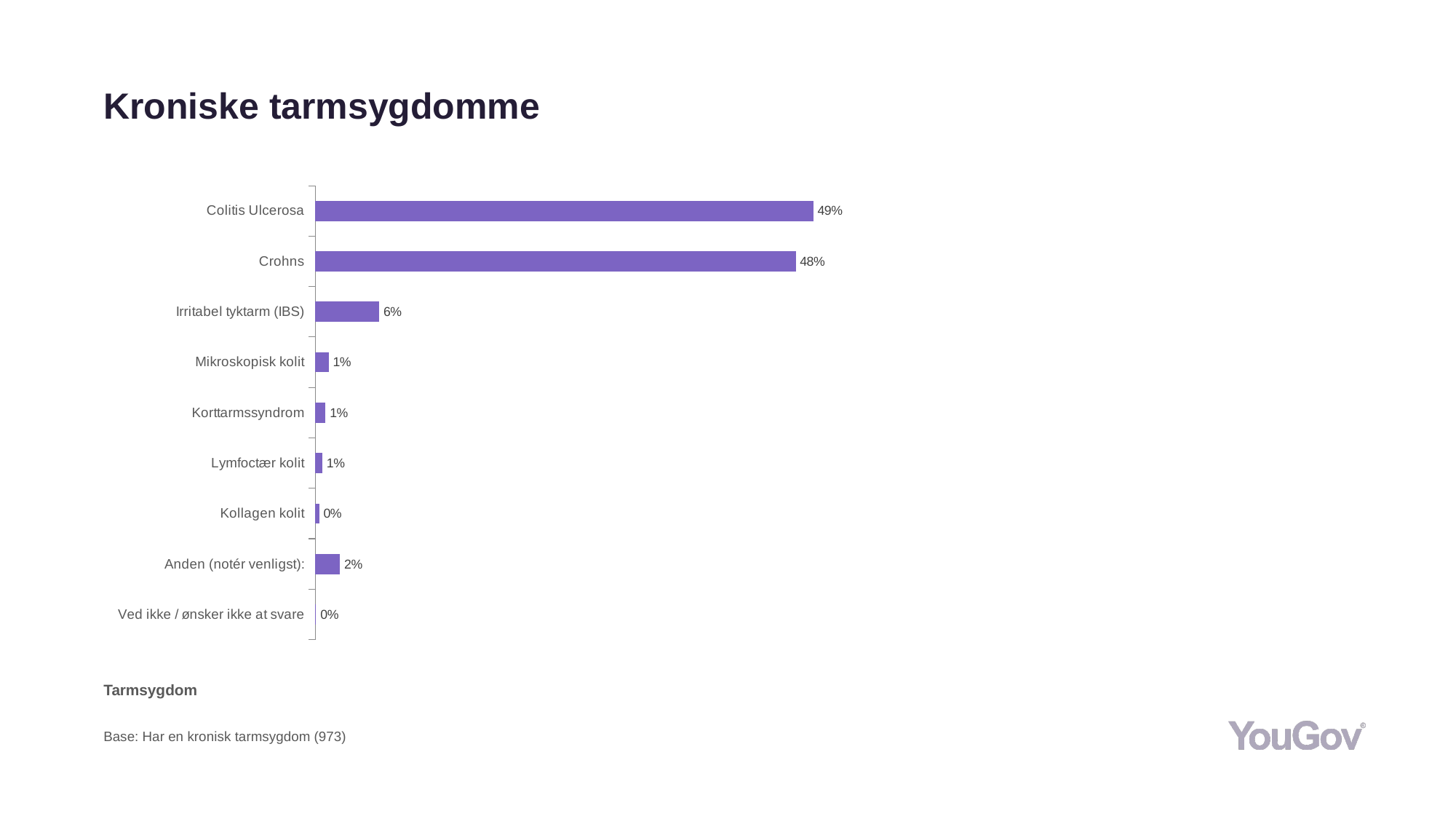
What is the value for Ved ikke / ønsker ikke at svare? 0% How many categories are shown in the chart? 9 What is the value for Crohns? 48% Which is larger, the value for Irritabel tyktarm (IBS) or the value for Anden (notér venligst):? Irritabel tyktarm (IBS) Which category has the highest value? Colitis Ulcerosa What kind of chart is shown on the slide? Bar chart What is the title of the slide? Kroniske tarmsygdomme What is the value for Colitis Ulcerosa? 49% What is the value for Anden (notér venligst):? 2% What is the difference between the values for Crohns and Anden (notér venligst):? 46% What is the value for Irritabel tyktarm (IBS)? 6% What is the difference between the values for Colitis Ulcerosa and Irritabel tyktarm (IBS)? 43%